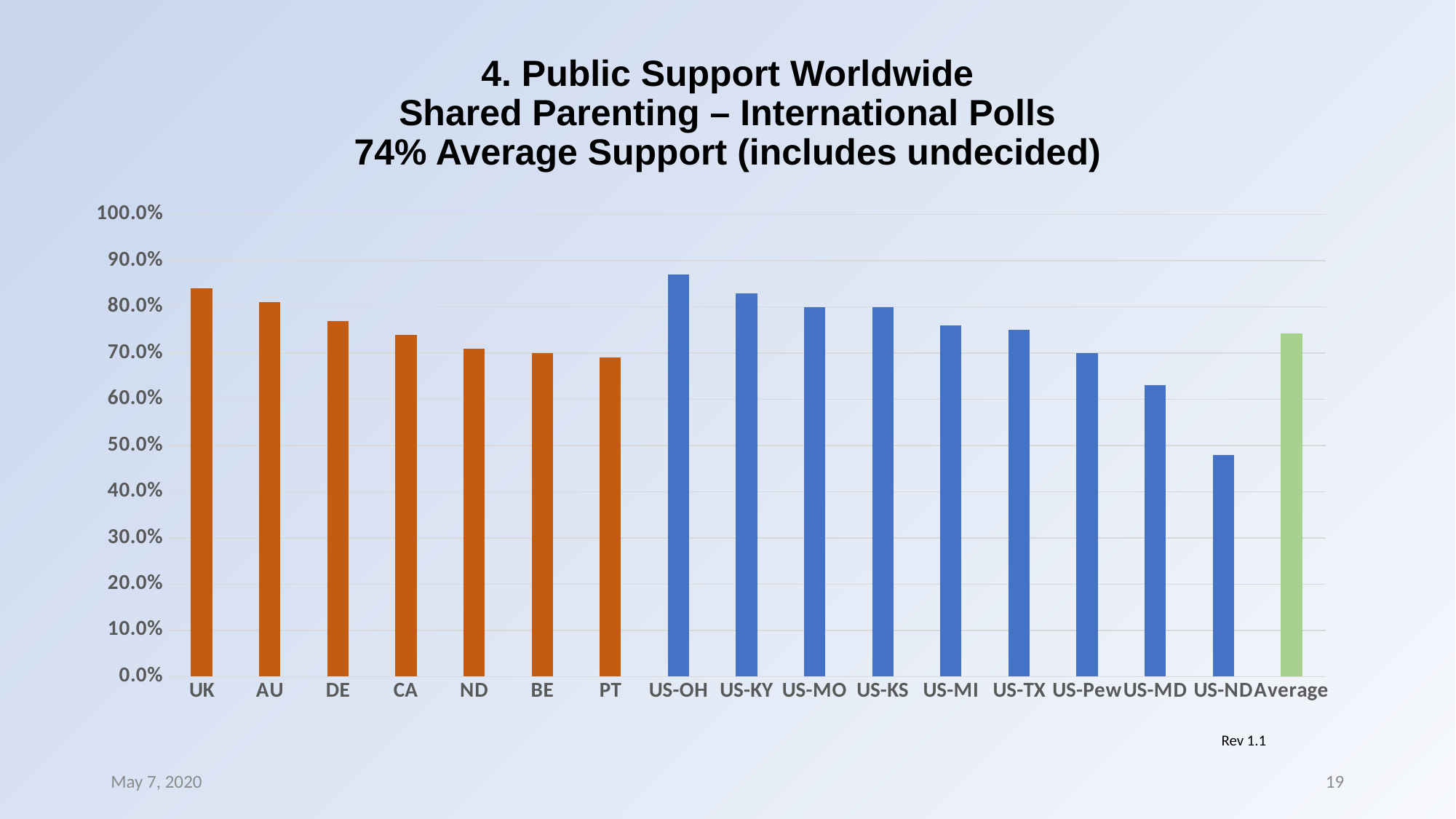
What colour is the Average bar? green Which is larger, the value for UK or the value for US-ND? UK Which category has the lowest bar? US-ND Do the values rise or fall from US-OH to US-ND along the x axis? fall Which category has the highest bar? US-OH What kind of chart is shown on the slide? bar chart Which is larger, the value for US-Pew or the value for US-MD? US-Pew Is the value for UK greater or less than 80.0%? greater Is the value for US-MD greater or less than 60.0%? greater How many categories are plotted along the x axis? 17 Is the value for US-ND greater or less than 50.0%? less